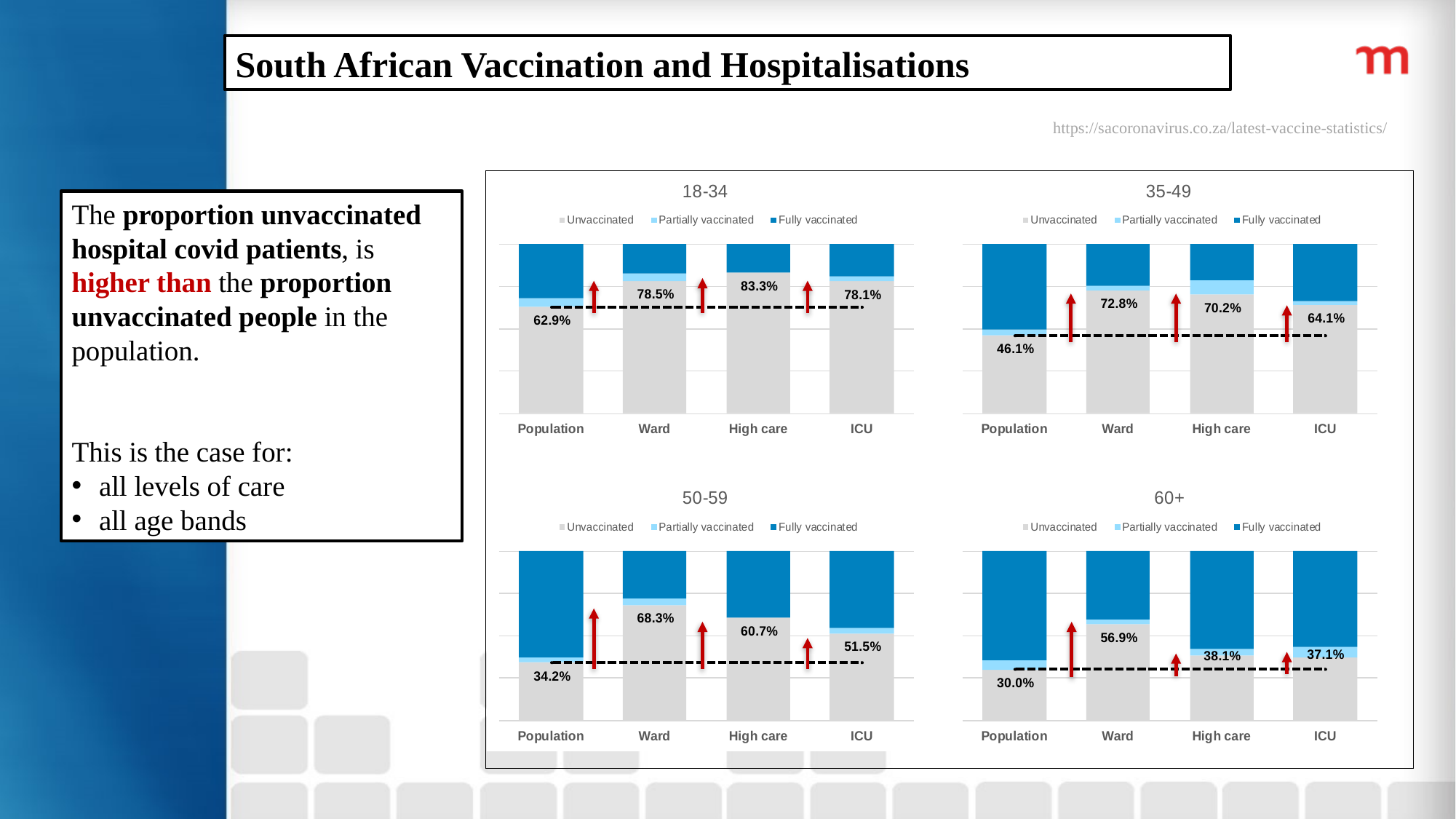
In the 18-34 chart, what is the unvaccinated percentage for Population? 62.9% How many categories are shown on the x axis of the 60+ chart? 4 In the 60+ chart, what is the unvaccinated percentage for Population? 30.0% What kind of chart is the 50-59 chart? Stacked bar chart In the 35-49 chart, what is the difference between the unvaccinated percentage for Ward and for Population? 26.7% In the 35-49 chart, what is the unvaccinated percentage for ICU? 64.1% In the 60+ chart, which category has the lowest unvaccinated percentage? Population In the 18-34 chart, what is the unvaccinated percentage for High care? 83.3% In the 18-34 chart, which category has the highest unvaccinated percentage? High care In the 50-59 chart, what is the unvaccinated percentage for Ward? 68.3% In the 50-59 chart, which has a larger unvaccinated percentage, High care or ICU? High care How many series does the legend of the 35-49 chart list? 3